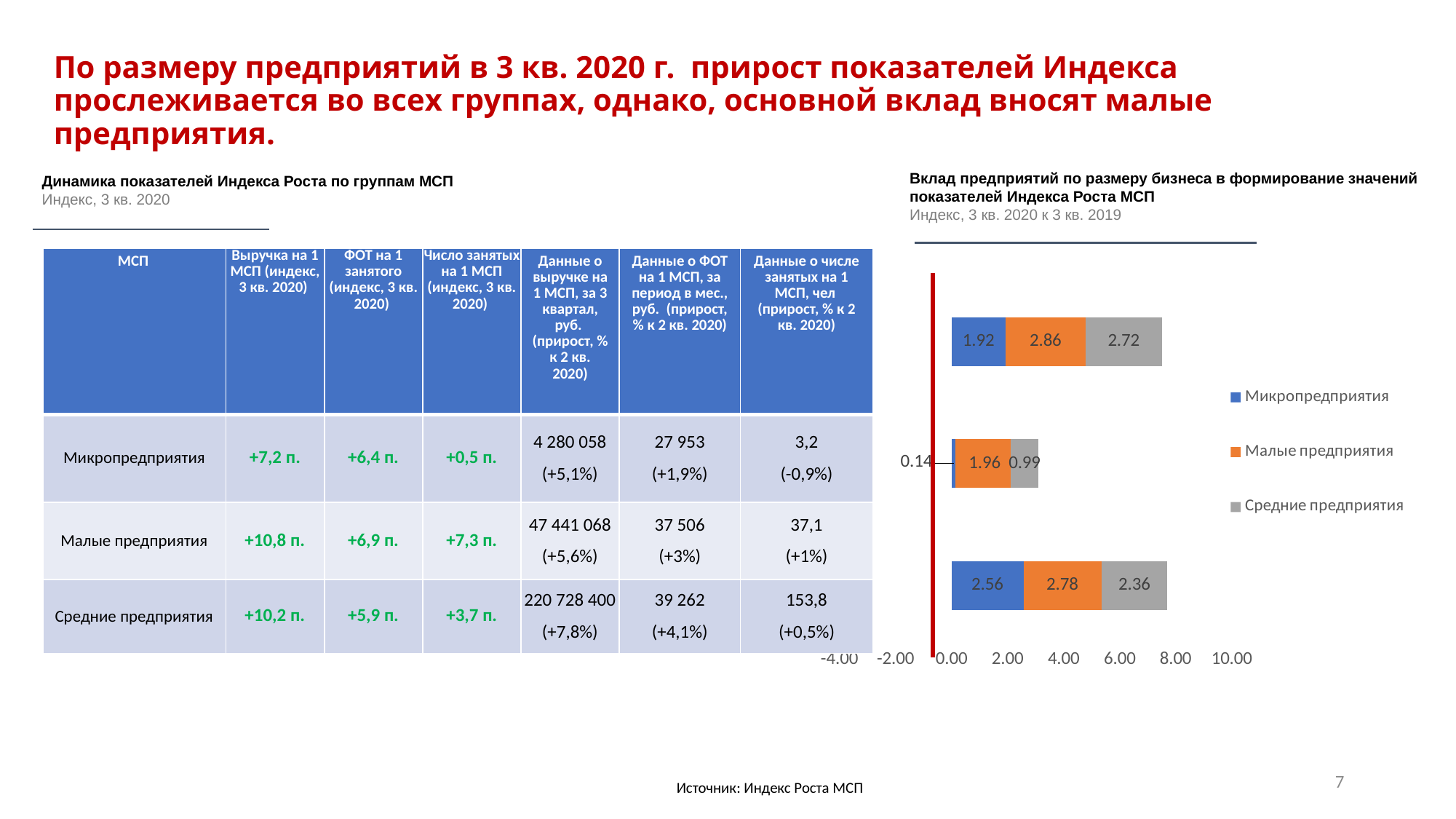
How many stacked bars are plotted in the chart on the right? 3 In the chart on the right, which series has the smallest segment in the top bar? Микропредприятия In the chart on the right, what is the value of the Микропредприятия segment in the middle bar? 0.14 In the chart on the right, what is the value of the Средние предприятия segment in the bottom bar? 2.36 In the chart on the right, what is the total of the middle stacked bar? 3.09 How many series does the legend of the chart on the right list? 3 In the chart on the right, which series has the largest segment in the middle bar? Малые предприятия In the chart on the right, what is the difference between the Микропредприятия segments of the bottom bar and the top bar? 0.64 In the chart on the right, which is larger: the Средние предприятия segment in the top bar or in the bottom bar? top bar In the chart on the right, what is the total of the top stacked bar? 7.50 In the chart on the right, what is the value of the Малые предприятия segment in the top bar? 2.86 What kind of chart is shown on the right side of the slide? stacked bar chart